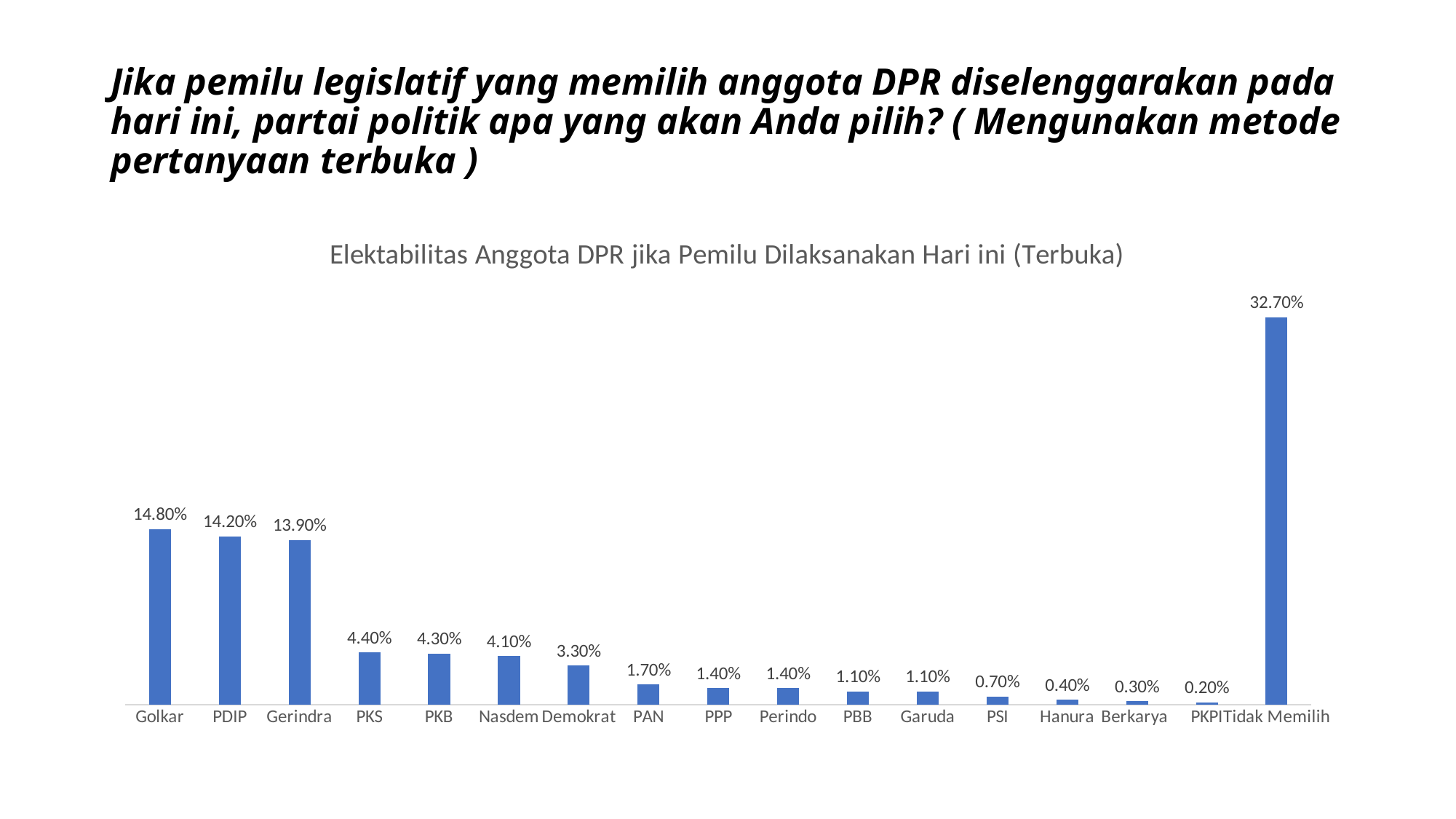
How many categories are shown on the x axis? 17 Which is larger, the value for PKS or the value for Nasdem? PKS What is the title of the chart? Elektabilitas Anggota DPR jika Pemilu Dilaksanakan Hari ini (Terbuka) What is the value for Demokrat? 3.30% What is the difference between the values for Golkar and PDIP? 0.60% Which category has the highest value? Tidak Memilih What kind of chart is shown on the slide? Bar chart What is the value for Tidak Memilih? 32.70% What is the value for Hanura? 0.40% What is the value for Golkar? 14.80% What is the difference between the values for Tidak Memilih and Gerindra? 18.80% Which category has the lowest value? PKPI